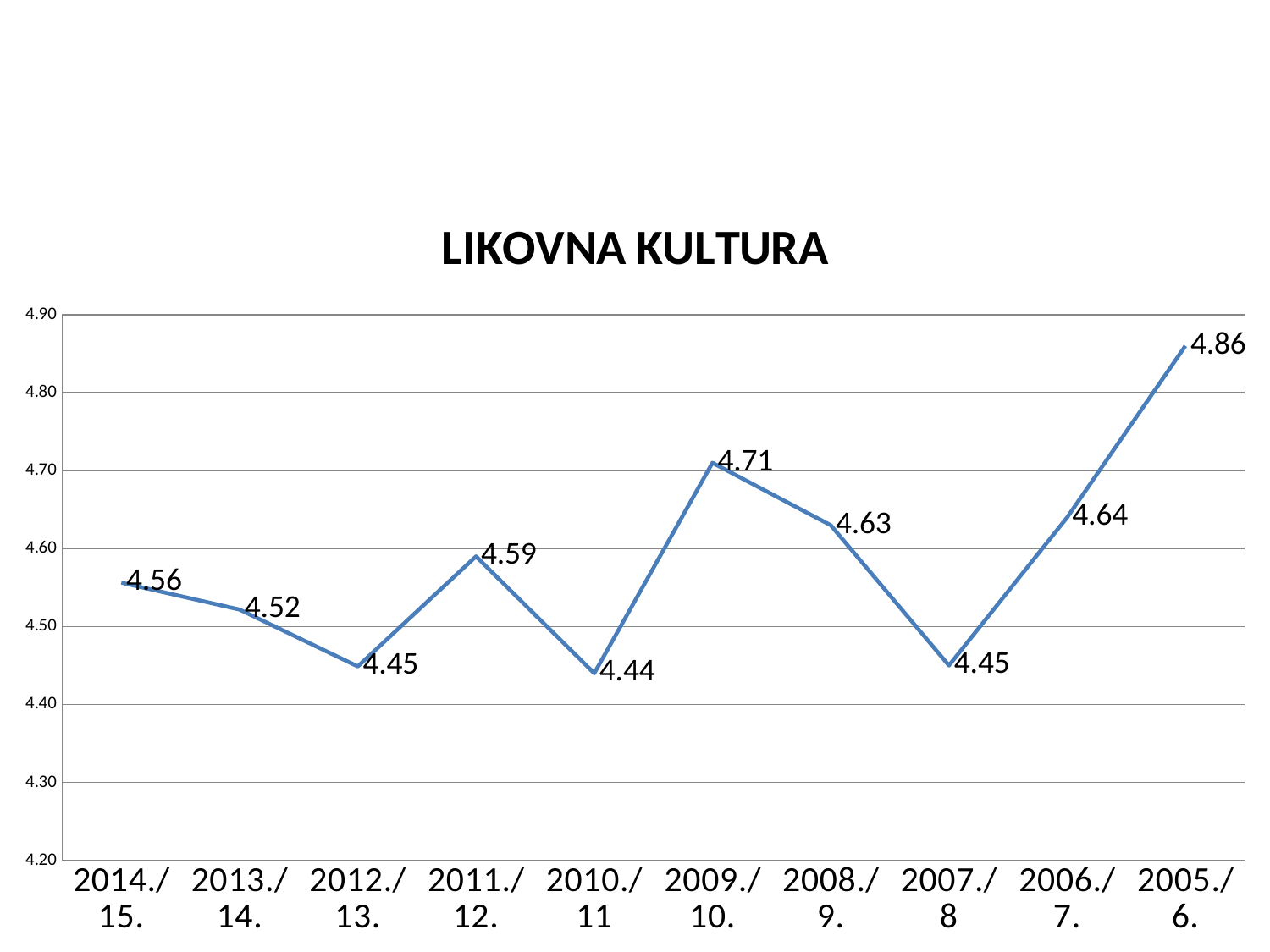
Which category has the lowest value? 2010./11 What is the difference between the values for 2009./10. and 2008./9.? 0.08 What is the difference between the values for 2005./6. and 2014./15.? 0.30 What is the value for 2005./6.? 4.86 Which is larger, the value for 2011./12. or the value for 2006./7.? 2006./7. What is the value for 2014./15.? 4.56 What is the value for 2009./10.? 4.71 How many categories are shown on the x axis? 10 Is the value for 2007./8 greater or less than 4.50? less What is the title of the chart? LIKOVNA KULTURA Which category has the highest value? 2005./6. What kind of chart is this? line chart